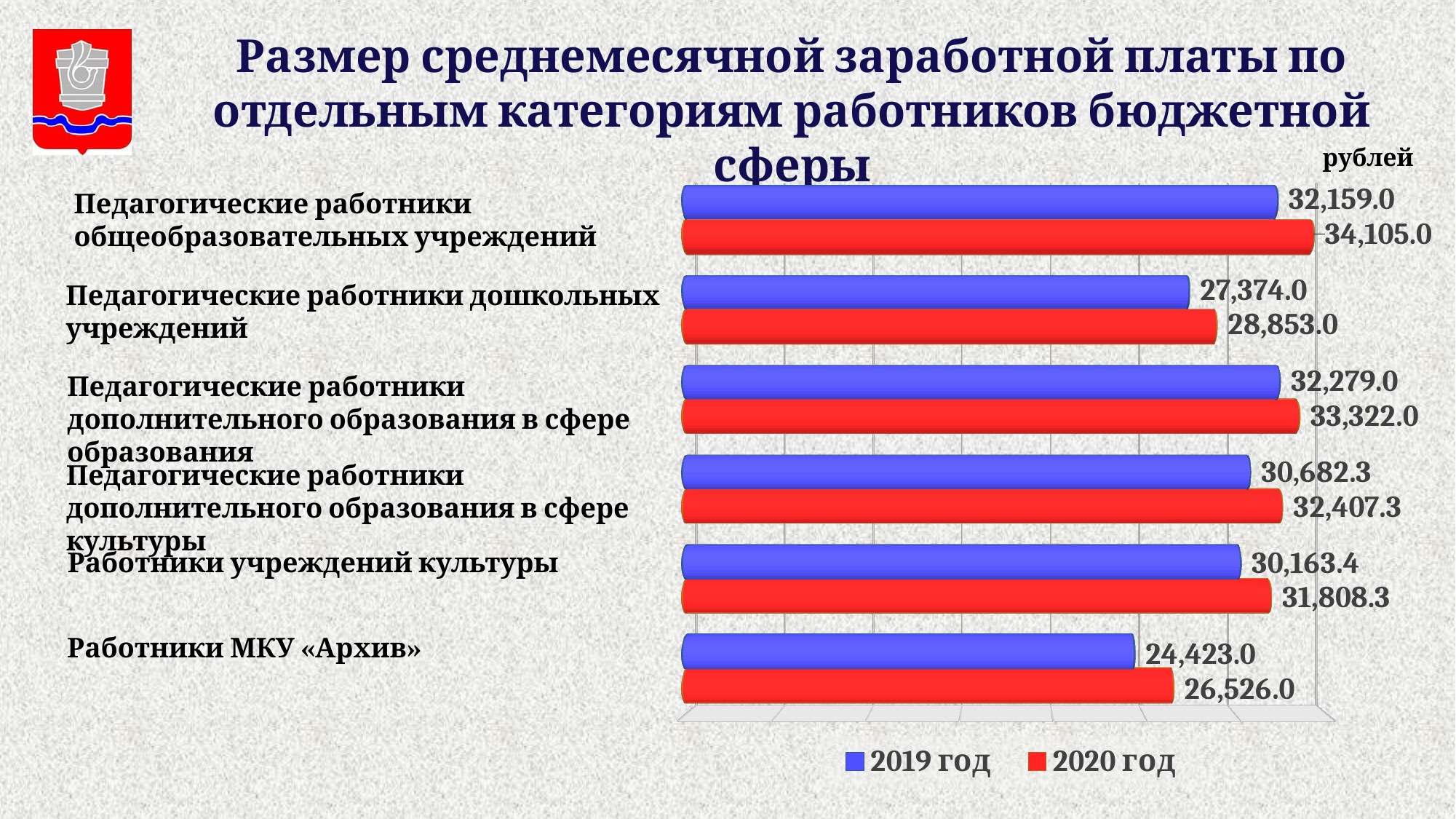
Which category has the highest 2020 год value? Педагогические работники общеобразовательных учреждений What is the difference between the 2020 год and 2019 год values for Работники МКУ «Архив»? 2,103.0 What is the 2019 год value for Работники МКУ «Архив»? 24,423.0 What is the 2019 год value for Педагогические работники дошкольных учреждений? 27,374.0 What is the 2020 год value for Работники учреждений культуры? 31,808.3 Which colour represents the 2019 год series in the chart? blue What type of chart is shown on the slide? bar chart How many series does the legend list? 2 What is the 2020 год value for Педагогические работники общеобразовательных учреждений? 34,105.0 How many categories of workers are shown in the chart? 6 Which is larger for Педагогические работники дополнительного образования в сфере культуры: the 2019 год value or the 2020 год value? 2020 год Which category has the lowest 2019 год value? Работники МКУ «Архив»